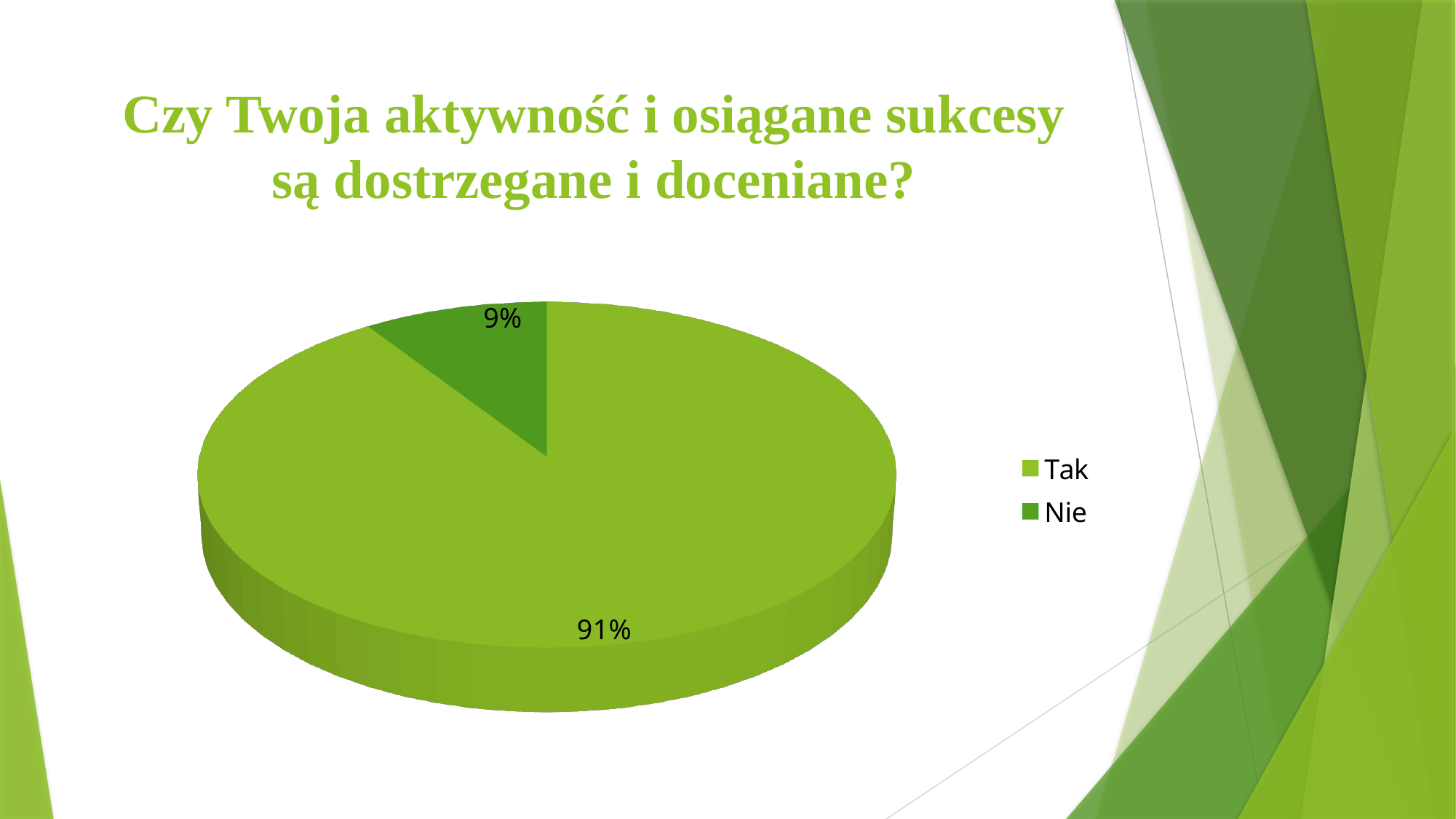
What share of the pie does "Tak" represent? 91% How many entries does the legend list? 2 What is the title of the slide? Czy Twoja aktywność i osiągane sukcesy są dostrzegane i doceniane? Which category has the largest slice of the pie? Tak What is the difference in percentage points between the "Tak" and "Nie" slices? 82 Is the value for "Tak" greater or less than 50%? greater Which legend entry is shown in the darker green colour? Nie What kind of chart is shown on the slide? Pie chart What share of the pie does "Nie" represent? 9% Which category has the smallest slice of the pie? Nie Which slice is larger, "Tak" or "Nie"? Tak How many categories are shown in the pie chart? 2